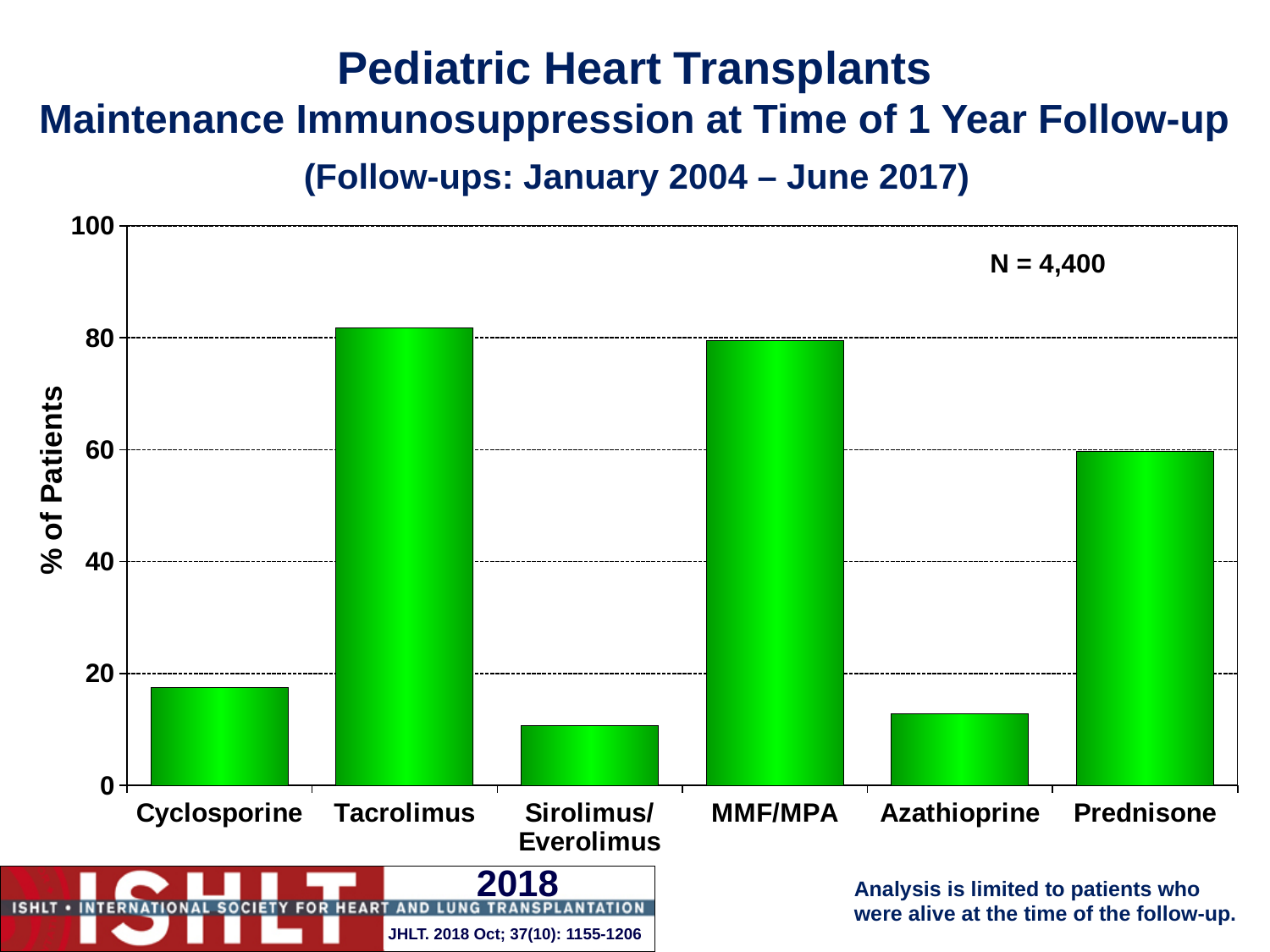
What is the label of the y axis of the chart? % of Patients Which category has the highest value in the chart? Tacrolimus Is the value for Azathioprine greater or less than 20? less Is the value for Prednisone greater or less than 40? greater Is the value for Cyclosporine greater or less than 20? less Which is larger, the value for Tacrolimus or the value for Prednisone? Tacrolimus Which is larger, the value for MMF/MPA or the value for Azathioprine? MMF/MPA How many categories are shown on the x axis of the chart? 6 What type of chart is shown on the slide? bar chart